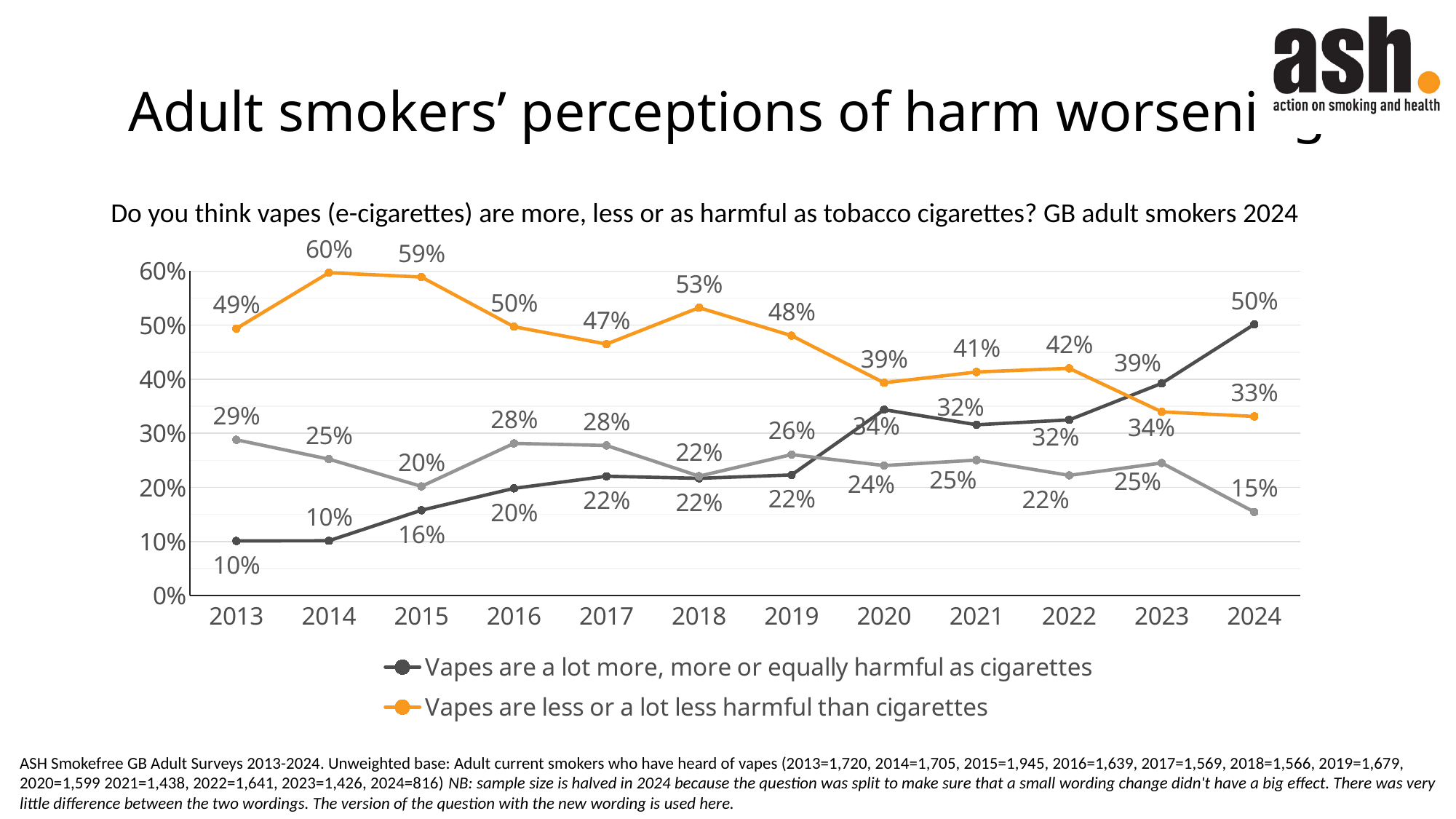
In which year was the value for 'Vapes are less or a lot less harmful than cigarettes' highest? 2014 From 2014 to 2024, does the value for 'Vapes are less or a lot less harmful than cigarettes' generally rise or fall? Fall In 2023, which series has the higher value: 'Vapes are a lot more, more or equally harmful as cigarettes' or 'Vapes are less or a lot less harmful than cigarettes'? Vapes are a lot more, more or equally harmful as cigarettes How many series does the chart legend list? 2 In which year was the value for 'Vapes are less or a lot less harmful than cigarettes' lowest? 2024 What kind of chart is shown on the slide? Line chart What is the 2020 value for the series 'Vapes are a lot more, more or equally harmful as cigarettes'? 34% By how many percentage points did the 'Vapes are less or a lot less harmful than cigarettes' value fall from 2014 to 2024? 27 percentage points What is the 2024 value for the series 'Vapes are a lot more, more or equally harmful as cigarettes'? 50% What survey question is shown as the chart's title? Do you think vapes (e-cigarettes) are more, less or as harmful as tobacco cigarettes? GB adult smokers 2024 What percentage of GB adult smokers in 2014 thought vapes are less or a lot less harmful than cigarettes? 60% How many years are shown on the x axis of the chart? 12